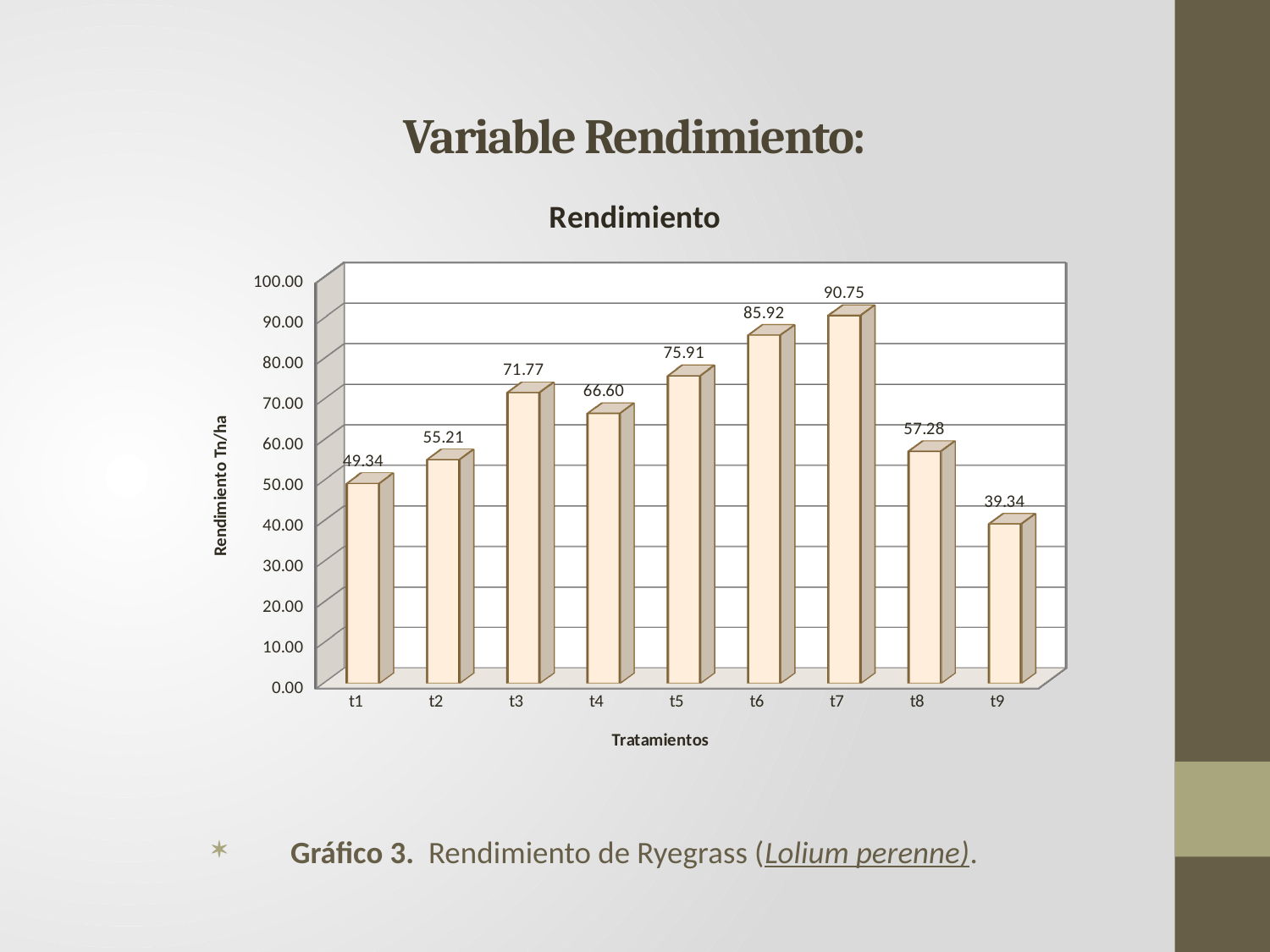
What is the value for t4? 66.60 Which is larger, the value for t3 or the value for t8? t3 What is the difference between the values for t7 and t9? 51.41 Is the value for t6 greater or less than 80.00? greater Which treatment has the highest Rendimiento? t7 What is the value for t1? 49.34 Which treatment has the lowest Rendimiento? t9 What kind of chart is shown? bar chart What is the title of the chart? Rendimiento What is the difference between the values for t6 and t5? 10.01 How many treatments are shown on the x axis? 9 What is the value for t7? 90.75